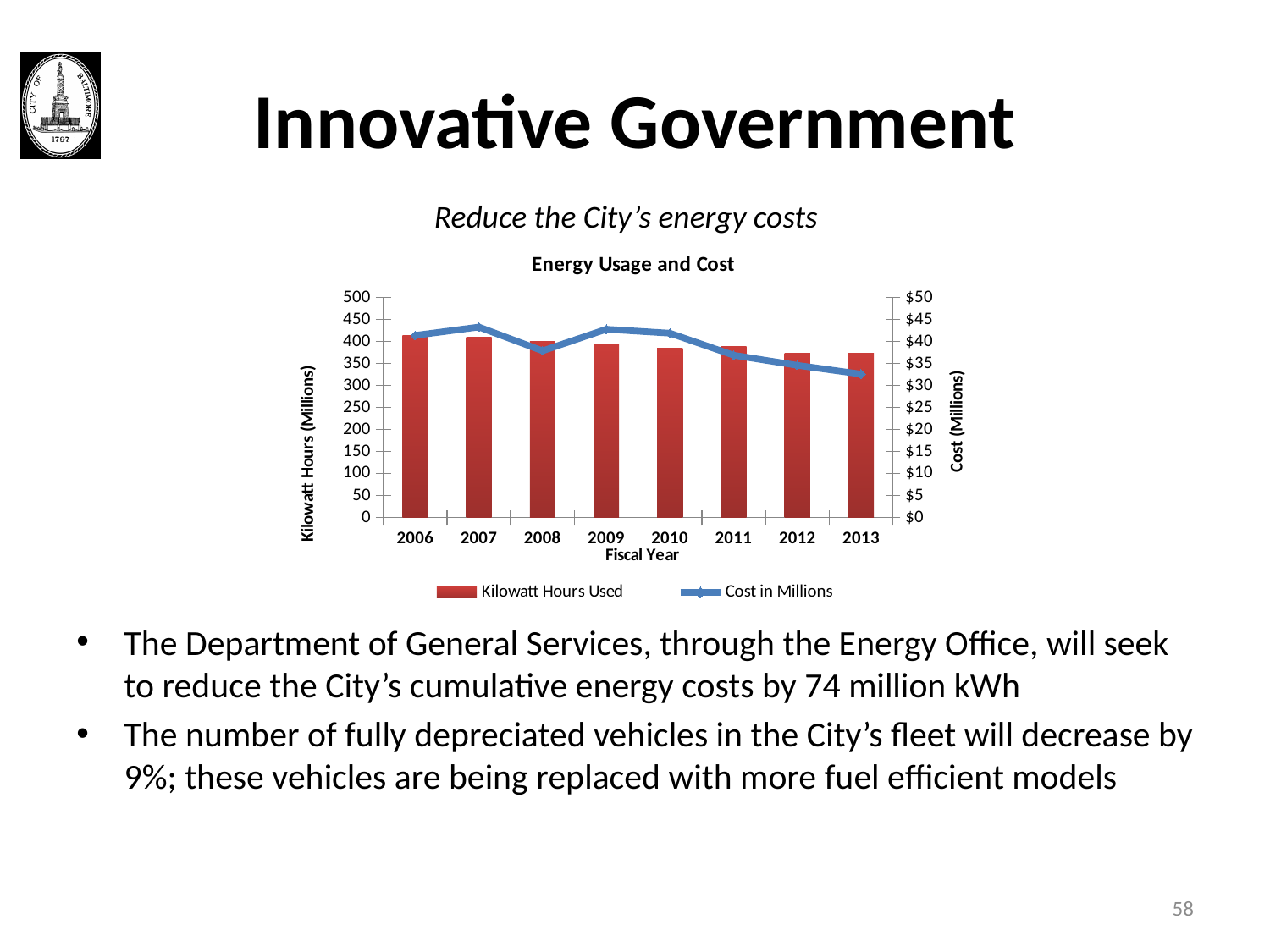
What is the label of the left vertical axis on the 'Energy Usage and Cost' chart? Kilowatt Hours (Millions) What kind of chart is the 'Energy Usage and Cost' chart? A combination bar and line chart Which fiscal year has the lowest Cost in Millions value? 2013 Is the Cost in Millions value for 2013 greater or less than $40? less Is the Kilowatt Hours Used value for 2012 greater or less than 400? less Which is larger, the Kilowatt Hours Used value for 2006 or for 2013? 2006 What are the two series named in the legend of the 'Energy Usage and Cost' chart? Kilowatt Hours Used and Cost in Millions Is the Kilowatt Hours Used value for 2013 greater or less than 400? less How many fiscal years are shown on the x axis of the 'Energy Usage and Cost' chart? 8 How many series does the legend of the 'Energy Usage and Cost' chart list? 2 Does the Cost in Millions line generally rise or fall from 2006 to 2013? fall